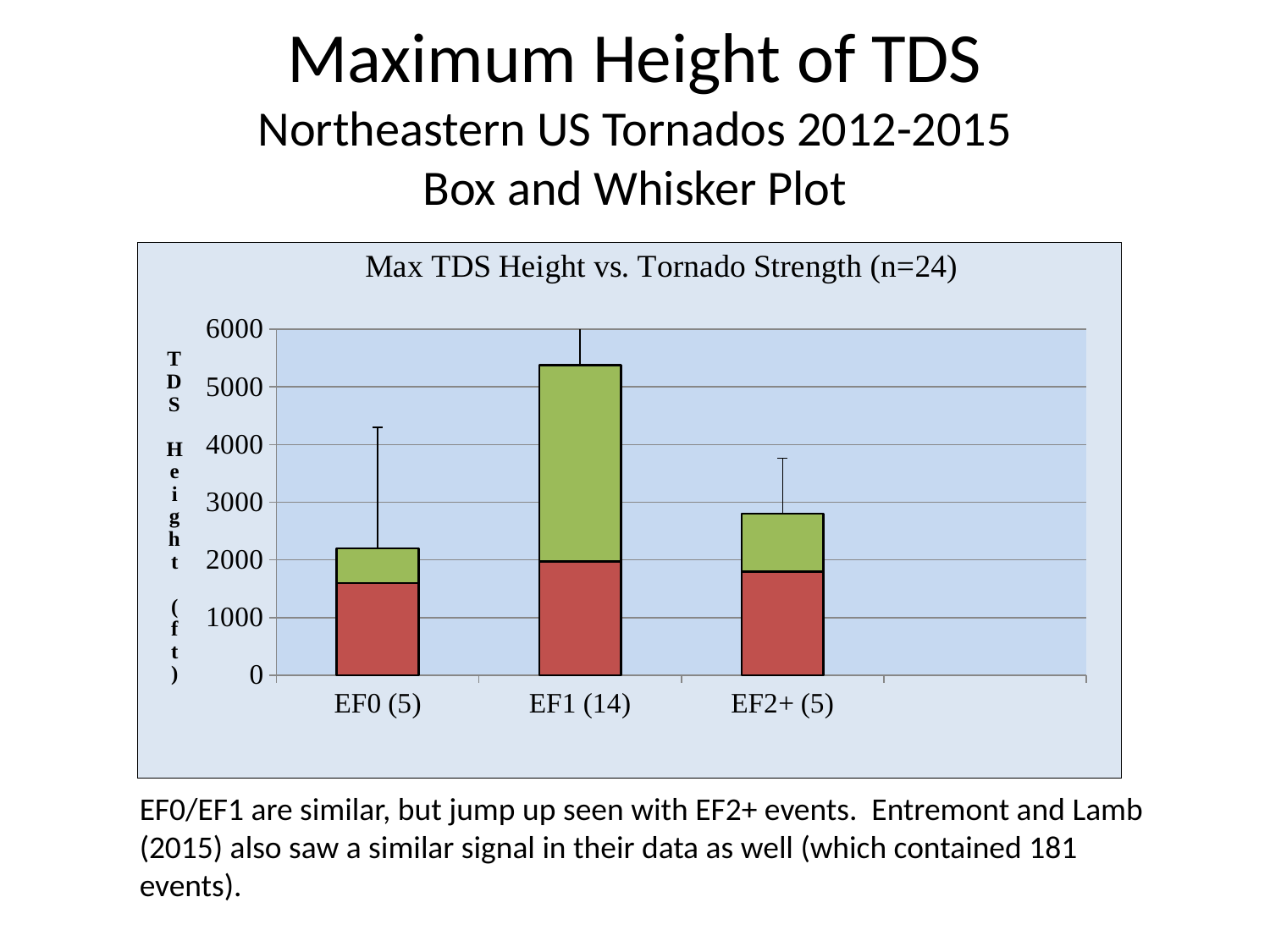
Is the top of the box for EF2+ (5) greater or less than 4000? less How many tornado strength categories are shown on the x axis? 3 Which category has the tallest box (highest top of the green section)? EF1 (14) Is the top of the red section for EF0 (5) greater or less than 2000? less What kind of chart is shown on the slide? bar chart (box and whisker plot) What is the label of the vertical axis? TDS Height (ft) Is the top of the box for EF1 (14) greater or less than 5000? greater Which category has the lowest top of its box? EF0 (5) Which has a higher box top, EF1 (14) or EF2+ (5)? EF1 (14) What is the title of the chart? Max TDS Height vs. Tornado Strength (n=24)